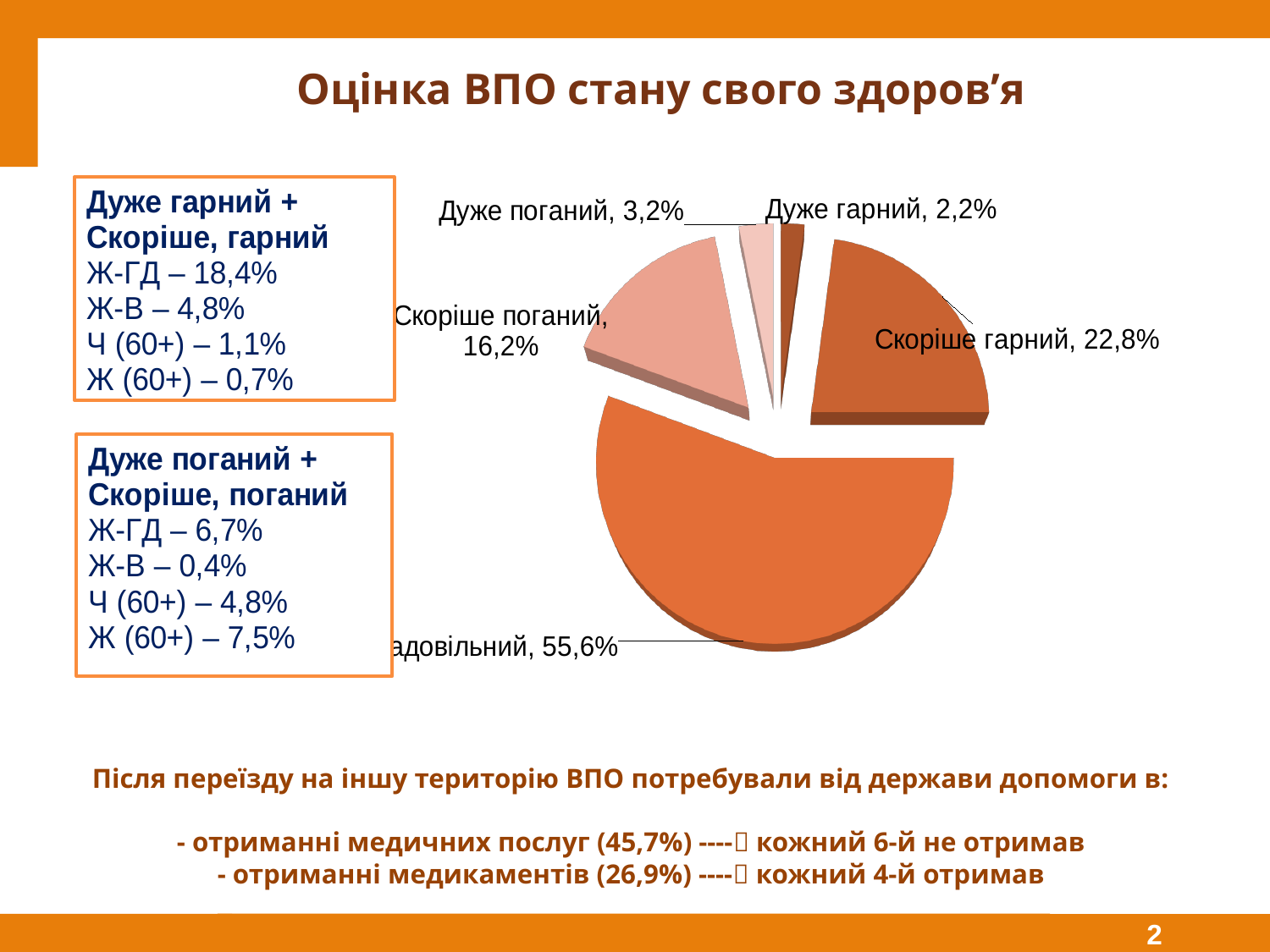
Which slice is larger: "Дуже поганий" or "Дуже гарний"? Дуже поганий What percentage is shown for the slice "Дуже гарний"? 2,2% What is the value of the largest slice in the pie chart? 55,6% How many slices does the pie chart have? 5 What is the difference between the "Скоріше гарний" and "Скоріше поганий" slices? 6,6% What is the title of the slide containing the pie chart? Оцінка ВПО стану свого здоров’я What is the difference between the "Скоріше поганий" and "Дуже поганий" slices? 13,0% What kind of chart is shown on the slide? pie chart Which slice of the pie chart is the smallest? Дуже гарний What percentage is shown for the slice "Дуже поганий"? 3,2% What percentage is shown for the slice "Скоріше гарний"? 22,8% What percentage is shown for the slice "Скоріше поганий"? 16,2%